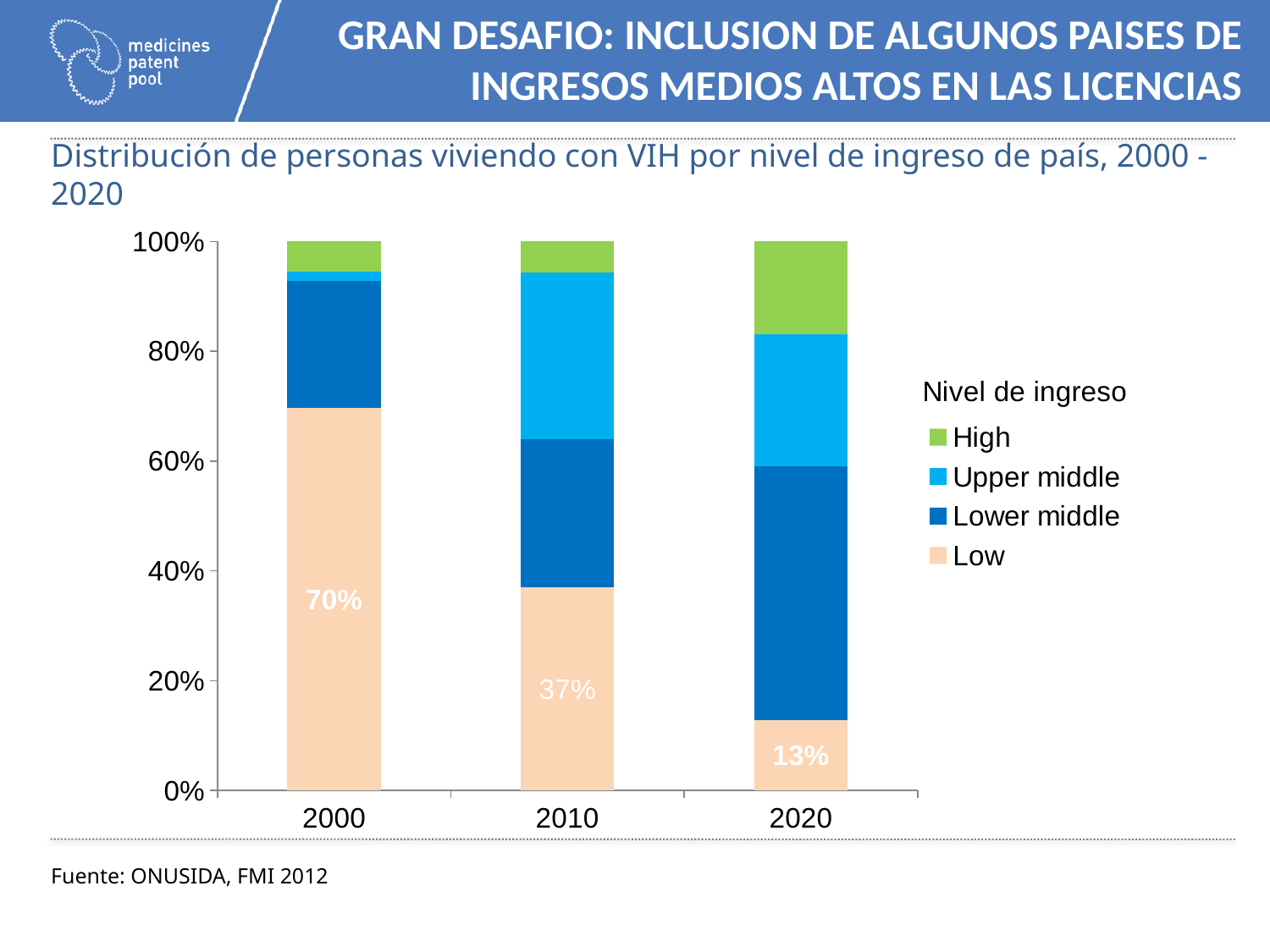
What is the value of the Low segment for 2010? 37% Is the Lower middle segment for 2020 greater or less than 40%? greater Does the Low income share rise or fall from 2000 to 2020? fall How many income levels does the legend list? 4 What is the title of the legend? Nivel de ingreso In which year is the Low income share the lowest? 2020 What share of the 2020 bar is labelled for the Low income level? 13% In which year is the Low income share the highest? 2000 What percentage of people living with HIV were in low-income countries in 2000? 70% What kind of chart is shown on the slide? stacked bar chart By how many percentage points did the Low share fall from 2000 to 2020? 57 percentage points How many years are shown on the x axis? 3